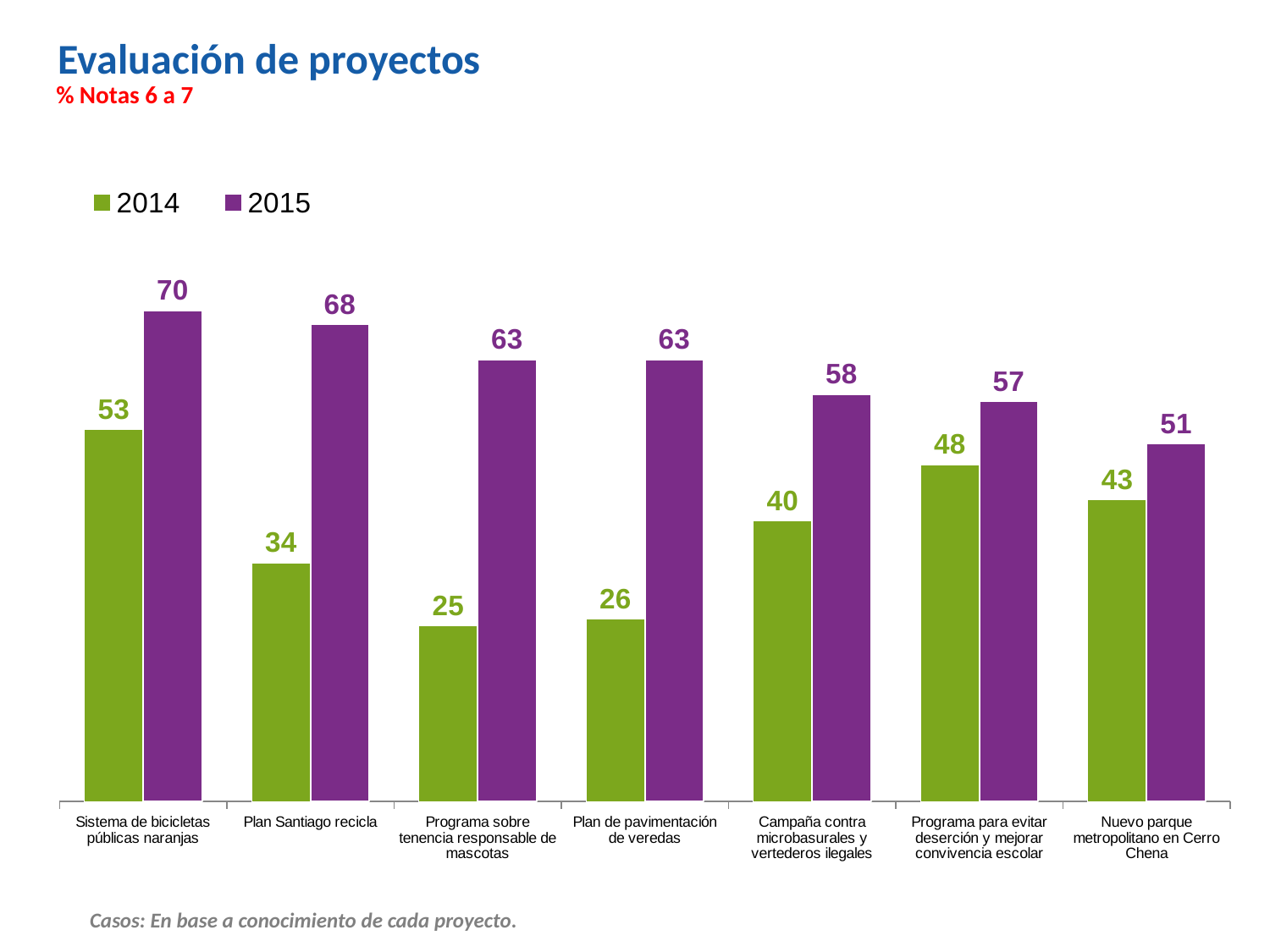
Which project has the lowest 2014 value? Programa sobre tenencia responsable de mascotas Which project has the highest 2015 value? Sistema de bicicletas públicas naranjas How many series does the legend list? 2 What is the 2015 value for Plan Santiago recicla? 68 What kind of chart is shown on the slide? Bar chart How many projects are shown on the x axis? 7 What is the 2014 value for Programa sobre tenencia responsable de mascotas? 25 Which is larger: the 2014 value for Sistema de bicicletas públicas naranjas or the 2014 value for Programa para evitar deserción y mejorar convivencia escolar? Sistema de bicicletas públicas naranjas What is the difference between the 2015 and 2014 values for Nuevo parque metropolitano en Cerro Chena? 8 What is the difference between the 2015 and 2014 values for Plan de pavimentación de veredas? 37 What is the 2014 value for Campaña contra microbasurales y vertederos ilegales? 40 Which colour represents the 2015 series? Purple